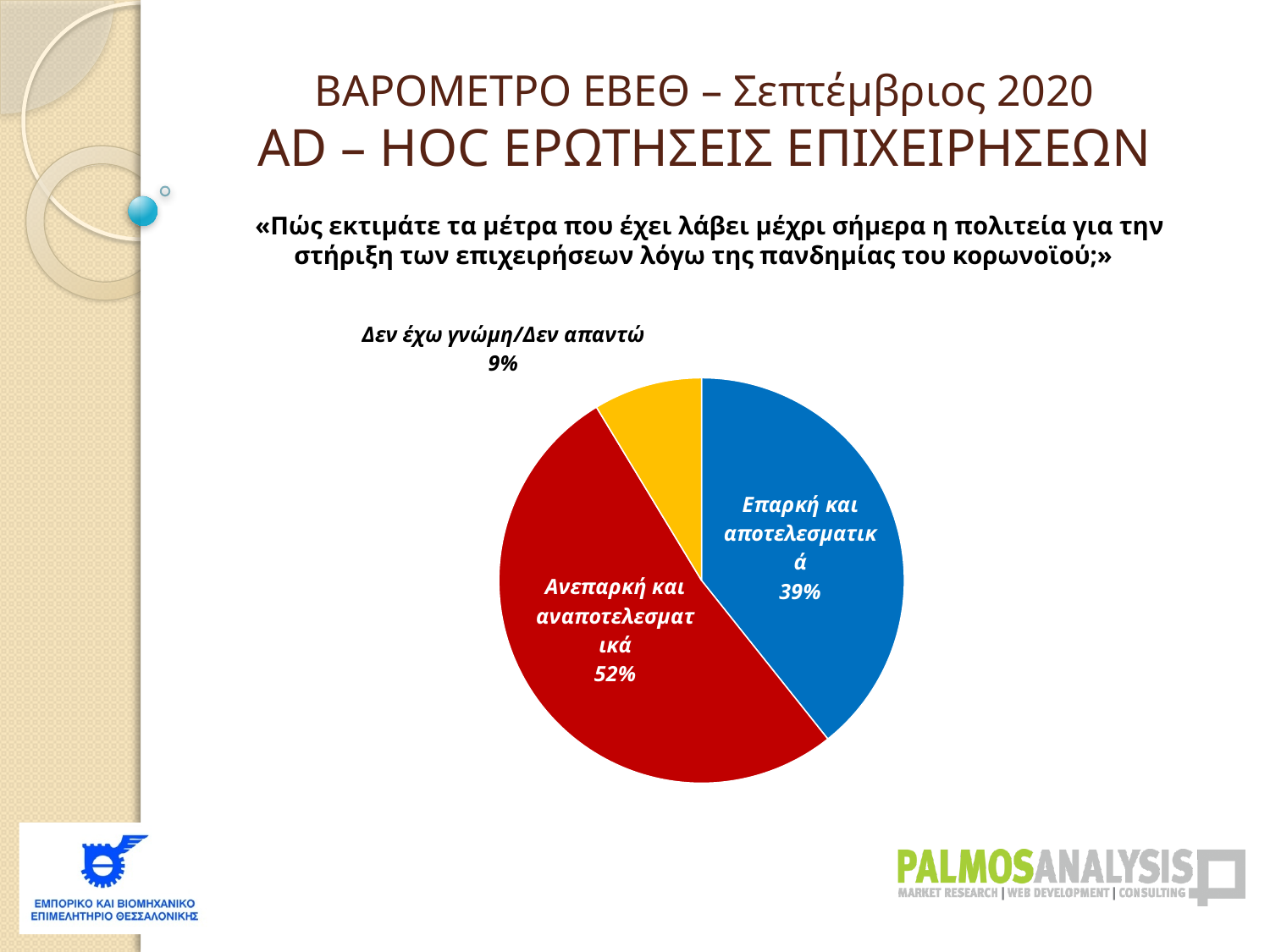
What is the difference in percentage points between «Ανεπαρκή και αναποτελεσματικά» and «Επαρκή και αποτελεσματικά»? 13 percentage points Which response has the largest share of the pie? Ανεπαρκή και αναποτελεσματικά Which response has the smallest share of the pie? Δεν έχω γνώμη/Δεν απαντώ What is the combined share of «Επαρκή και αποτελεσματικά» and «Δεν έχω γνώμη/Δεν απαντώ»? 48% What colour is the slice for «Δεν έχω γνώμη/Δεν απαντώ»? yellow What colour is the slice for «Ανεπαρκή και αναποτελεσματικά»? red What percentage of respondents answered «Ανεπαρκή και αναποτελεσματικά»? 52% Which is larger: the share for «Επαρκή και αποτελεσματικά» or the share for «Δεν έχω γνώμη/Δεν απαντώ»? Επαρκή και αποτελεσματικά How many slices does the pie chart have? 3 What percentage of respondents answered «Δεν έχω γνώμη/Δεν απαντώ»? 9% What kind of chart is shown on the slide? pie chart What percentage of respondents answered «Επαρκή και αποτελεσματικά»? 39%